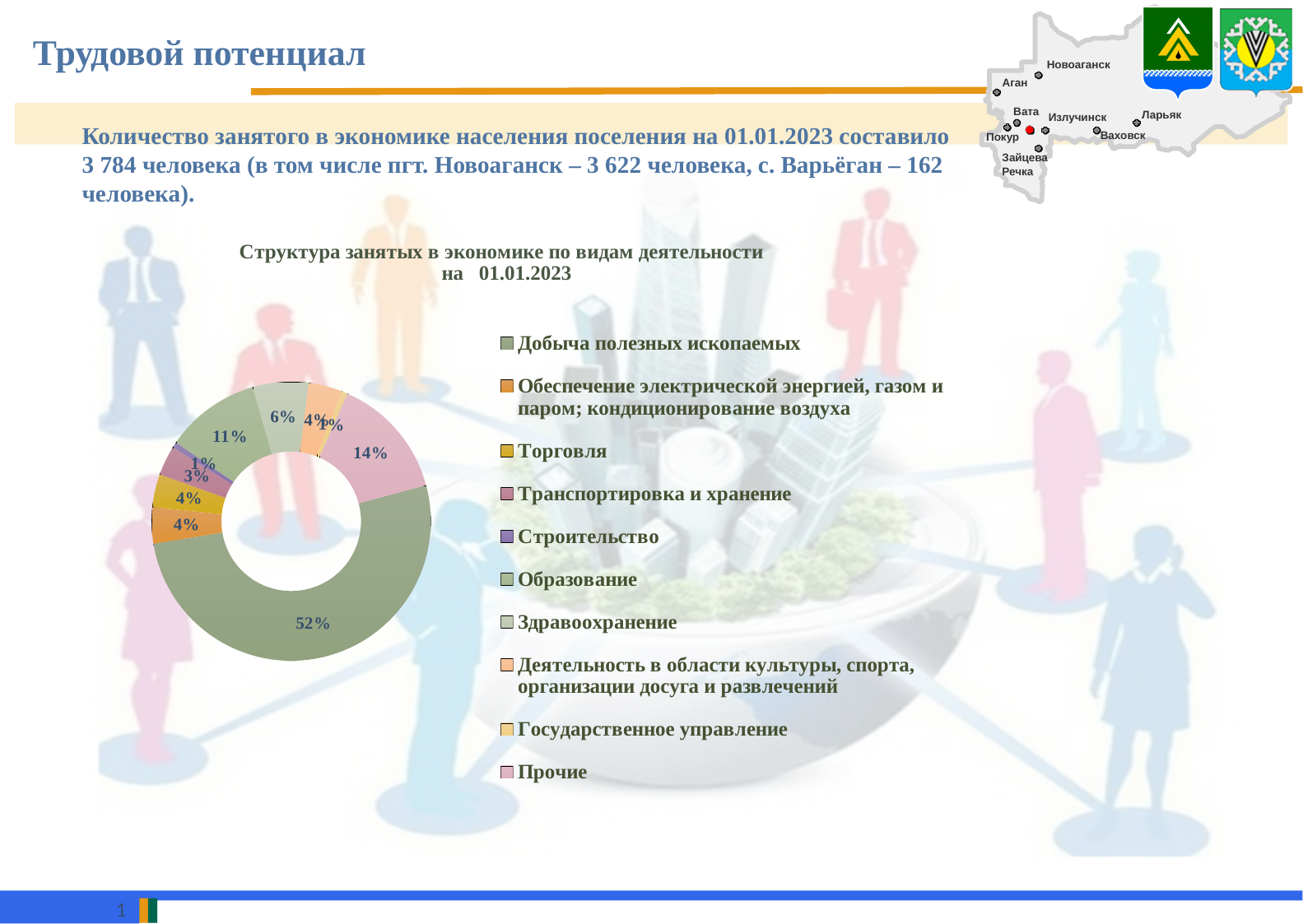
What is the share for "Образование" in the chart? 11% What percentage is shown for "Здравоохранение"? 6% What percentage does the "Прочие" slice show? 14% Which type of activity has the largest share of employed people in the chart? Добыча полезных ископаемых What share of employed people works in "Добыча полезных ископаемых" according to the chart? 52% What kind of chart is used to show the structure of employment by type of activity? Doughnut (pie) chart By how many percentage points does "Добыча полезных ископаемых" exceed "Прочие"? 38 Which has a larger share: "Образование" or "Здравоохранение"? Образование How many categories (types of activity) are shown in the chart? 10 What is the combined share of "Добыча полезных ископаемых" and "Прочие"? 66% What share does "Транспортировка и хранение" have? 3% What is the title of the chart on the slide? Структура занятых в экономике по видам деятельности на 01.01.2023